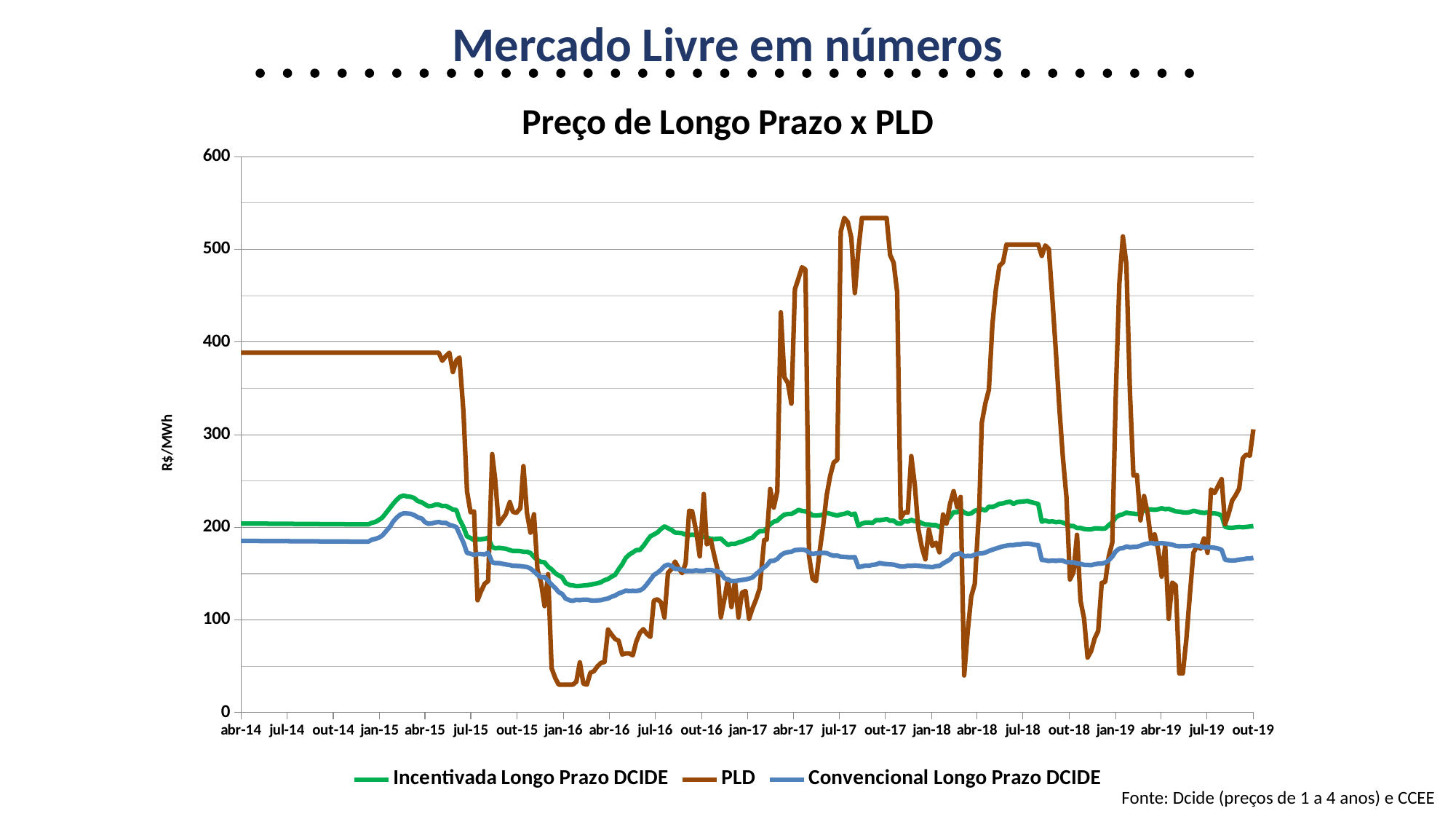
At abr-14, which series has the higher value, PLD or Convencional Longo Prazo DCIDE? PLD What kind of chart is shown on the slide? line chart Is the value of PLD at abr-14 greater or less than 300? greater Which series is drawn in green? Incentivada Longo Prazo DCIDE Is the value of PLD at jan-16 greater or less than 100? less At jan-16, which series has the higher value, Incentivada Longo Prazo DCIDE or PLD? Incentivada Longo Prazo DCIDE Is the value of Incentivada Longo Prazo DCIDE at abr-14 greater or less than 300? less Does the PLD series rise or fall between abr-15 and jan-16? fall What is the title of the chart? Preço de Longo Prazo x PLD How many series does the legend list? 3